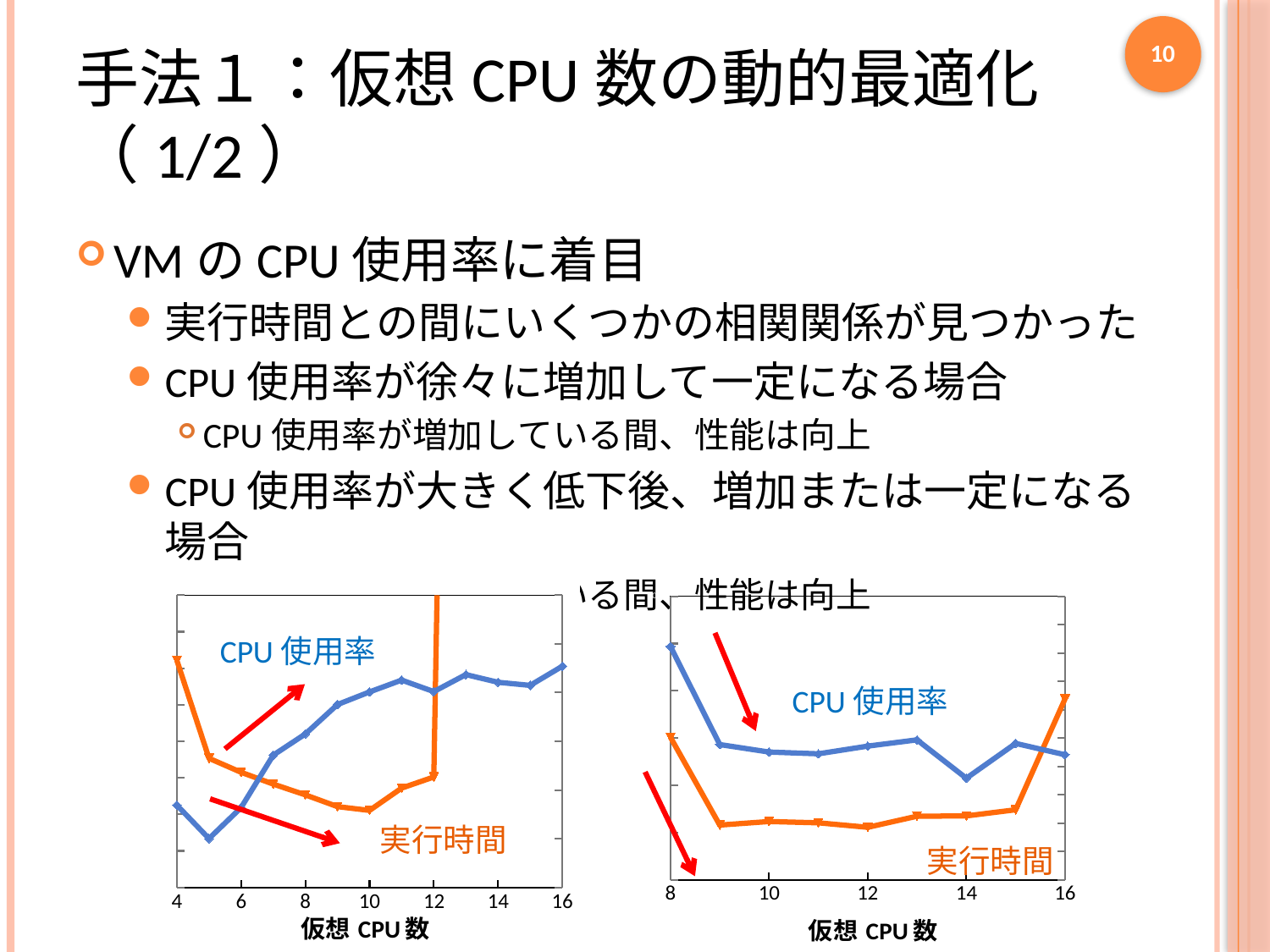
In the right chart, which colour is used for the 実行時間 line? orange In the left chart, at 4 virtual CPUs, which line is higher: CPU 使用率 or 実行時間? 実行時間 In the left chart, does the CPU 使用率 line rise or fall between 5 and 11 virtual CPUs? rise In the right chart, at 16 virtual CPUs, which line is higher: CPU 使用率 or 実行時間? 実行時間 In the left chart, how many data points does the CPU 使用率 line have? 13 In the right chart, how many data points does the 実行時間 line have? 9 How many data series are plotted in the left chart? 2 How many data series are plotted in the right chart? 2 What kind of chart is the left chart on the slide? line chart What kind of chart is the right chart on the slide? line chart In the left chart, what is the x-axis title? 仮想 CPU 数 In the right chart, does the 実行時間 line rise or fall between 8 and 9 virtual CPUs? fall